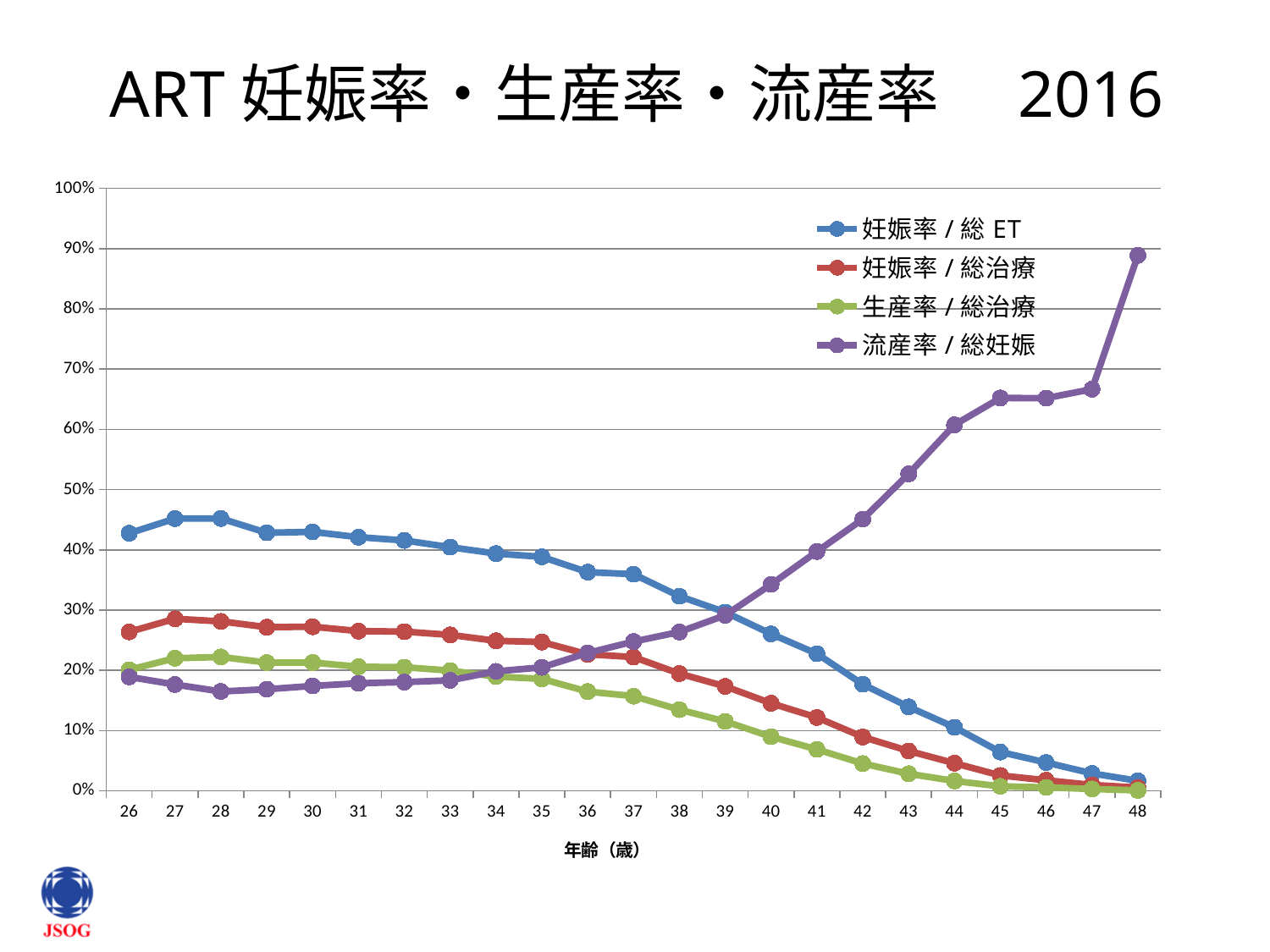
Is the value of 流産率 / 総妊娠 at age 48 greater or less than 80%? greater Does the 妊娠率 / 総 ET series rise or fall as age increases from 26 to 48? fall Is the value of 妊娠率 / 総治療 at age 40 greater or less than 20%? less What is the label of the x axis? 年齢（歳） Does the 流産率 / 総妊娠 series rise or fall as age increases from 34 to 48? rise How many series does the legend list? 4 Is the value of 妊娠率 / 総 ET at age 26 greater or less than 40%? greater At age 30, which is larger: 妊娠率 / 総 ET or 生産率 / 総治療? 妊娠率 / 総 ET How many age categories are plotted along the x axis? 23 What kind of chart is shown on the slide? line chart At which age is 流産率 / 総妊娠 highest? 48